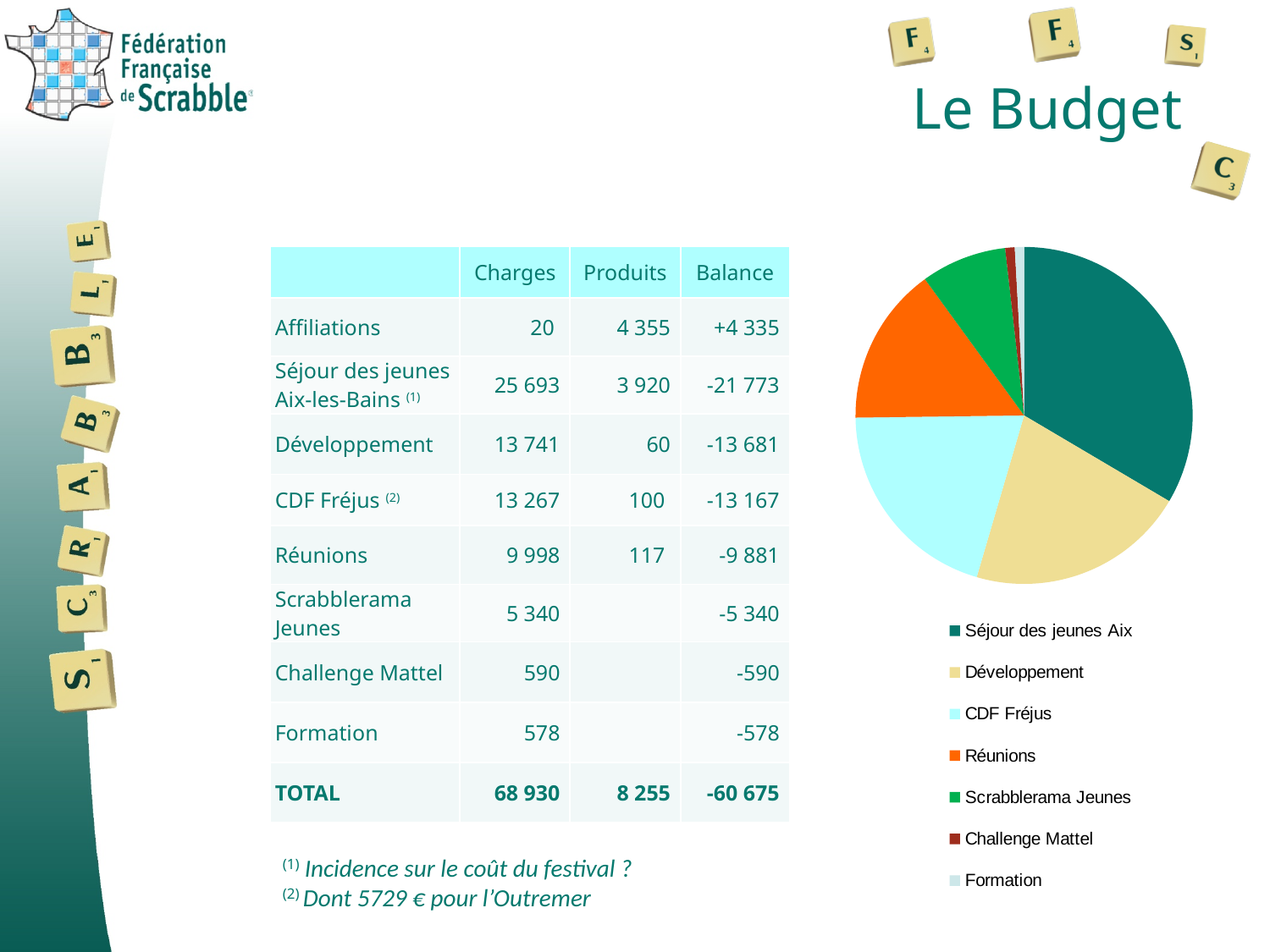
How many entries does the pie chart's legend list? 7 Which legend entry is listed first in the pie chart's legend? Séjour des jeunes Aix In the pie chart, which slice is larger: CDF Fréjus or Scrabblerama Jeunes? CDF Fréjus In the pie chart, which slice is larger: Séjour des jeunes Aix or Développement? Séjour des jeunes Aix Which category has the largest slice in the pie chart? Séjour des jeunes Aix In the pie chart, which slice is larger: Développement or Réunions? Développement How many slices does the pie chart have? 7 What kind of chart is shown on the slide? pie chart Which legend entry of the pie chart is shown in orange? Réunions